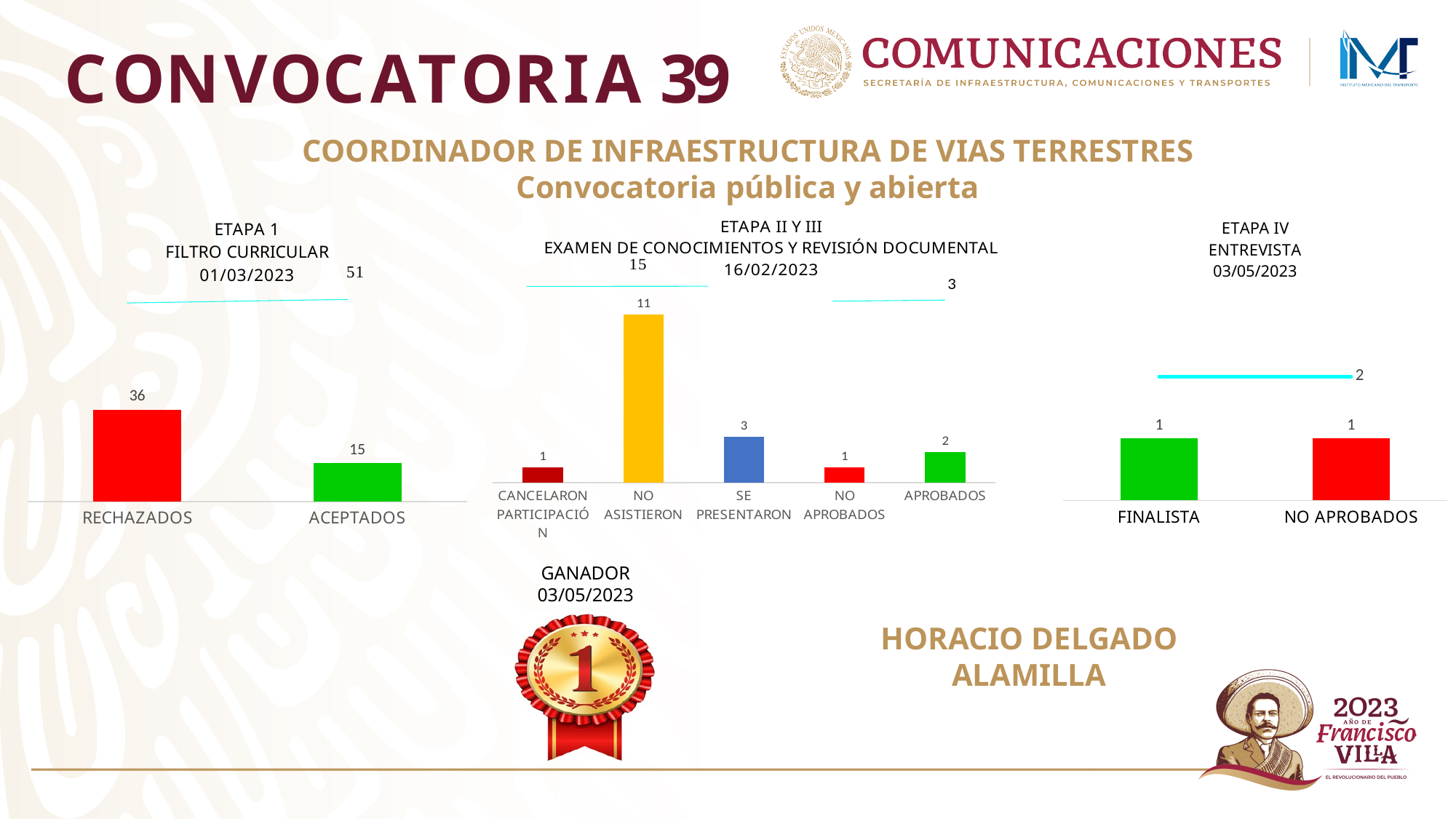
In the ETAPA 1 FILTRO CURRICULAR chart, which category is higher, RECHAZADOS or ACEPTADOS? RECHAZADOS In the ETAPA 1 FILTRO CURRICULAR chart, what is the difference between RECHAZADOS and ACEPTADOS? 21 In the ETAPA II Y III chart, which category has the highest value? NO ASISTIERON In the ETAPA II Y III chart, what is the value for APROBADOS? 2 In the ETAPA II Y III chart, what is the value for SE PRESENTARON? 3 In the ETAPA IV ENTREVISTA chart, what is the value for FINALISTA? 1 In the ETAPA II Y III chart, what is the value for NO ASISTIERON? 11 What type of chart is the ETAPA IV ENTREVISTA chart? Combination bar and line chart How many bar categories are shown in the ETAPA II Y III chart? 5 What colour is the NO ASISTIERON bar in the ETAPA II Y III chart? Yellow In the ETAPA 1 FILTRO CURRICULAR chart, what is the value for RECHAZADOS? 36 In the ETAPA 1 FILTRO CURRICULAR chart, what is the value for ACEPTADOS? 15